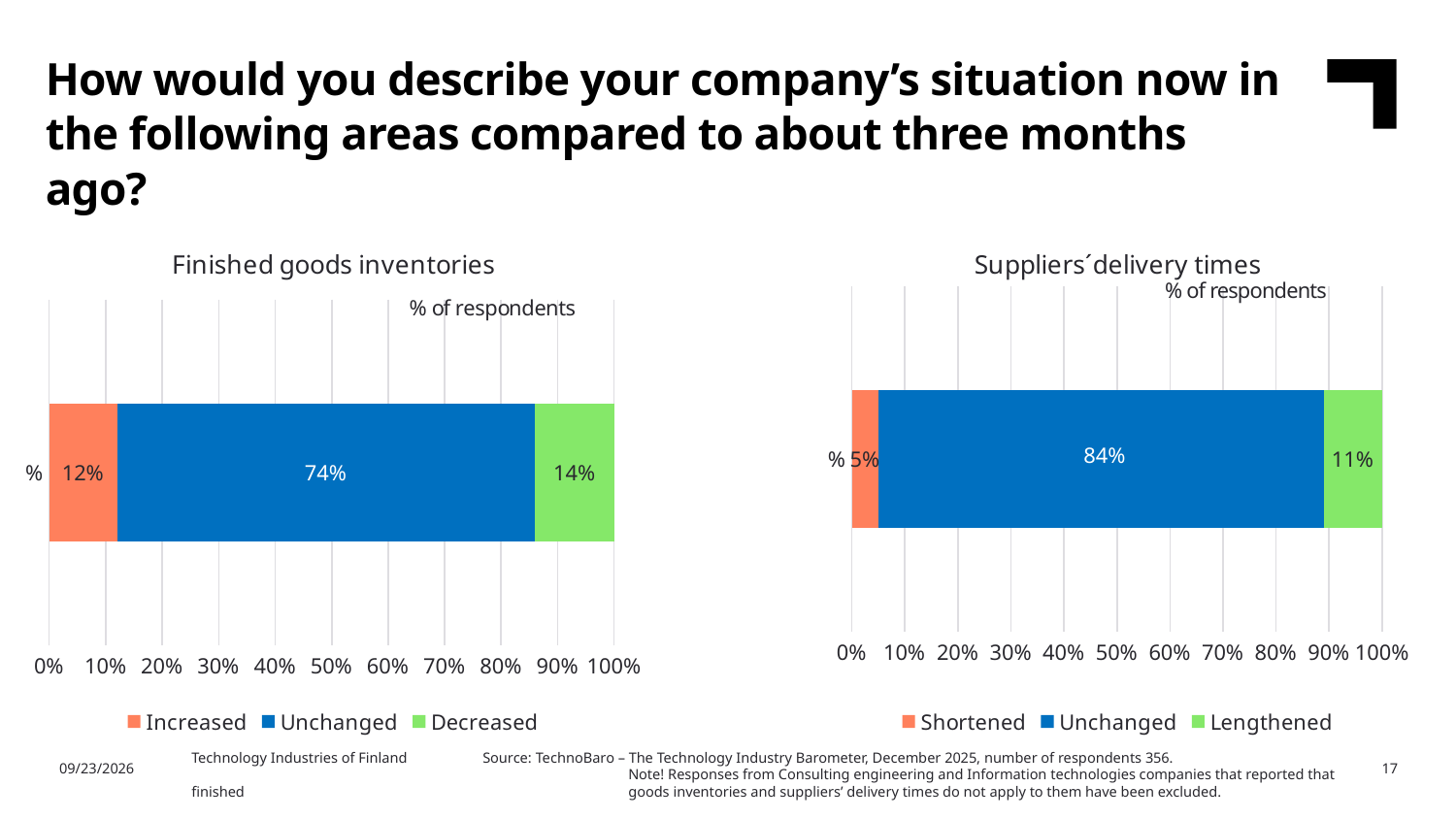
In the 'Suppliers´delivery times' chart, which is larger: 'Shortened' or 'Lengthened'? Lengthened In the 'Finished goods inventories' chart, what is the difference between the 'Unchanged' and 'Decreased' shares? 60 percentage points What type of chart is the 'Finished goods inventories' chart? Stacked bar chart In the 'Finished goods inventories' chart, what percentage of respondents reported 'Unchanged'? 74% In the 'Suppliers´delivery times' chart, which response category has the smallest share? Shortened In the 'Finished goods inventories' chart, what percentage of respondents reported 'Increased'? 12% In the 'Finished goods inventories' chart, which response category has the largest share? Unchanged In the 'Suppliers´delivery times' chart, what percentage of respondents reported 'Unchanged'? 84% How many series does the legend of the 'Suppliers´delivery times' chart list? 3 In the 'Suppliers´delivery times' chart, what percentage of respondents reported 'Lengthened'? 11% In the 'Finished goods inventories' chart, what percentage of respondents reported 'Decreased'? 14% In the 'Suppliers´delivery times' chart, what percentage of respondents reported 'Shortened'? 5%